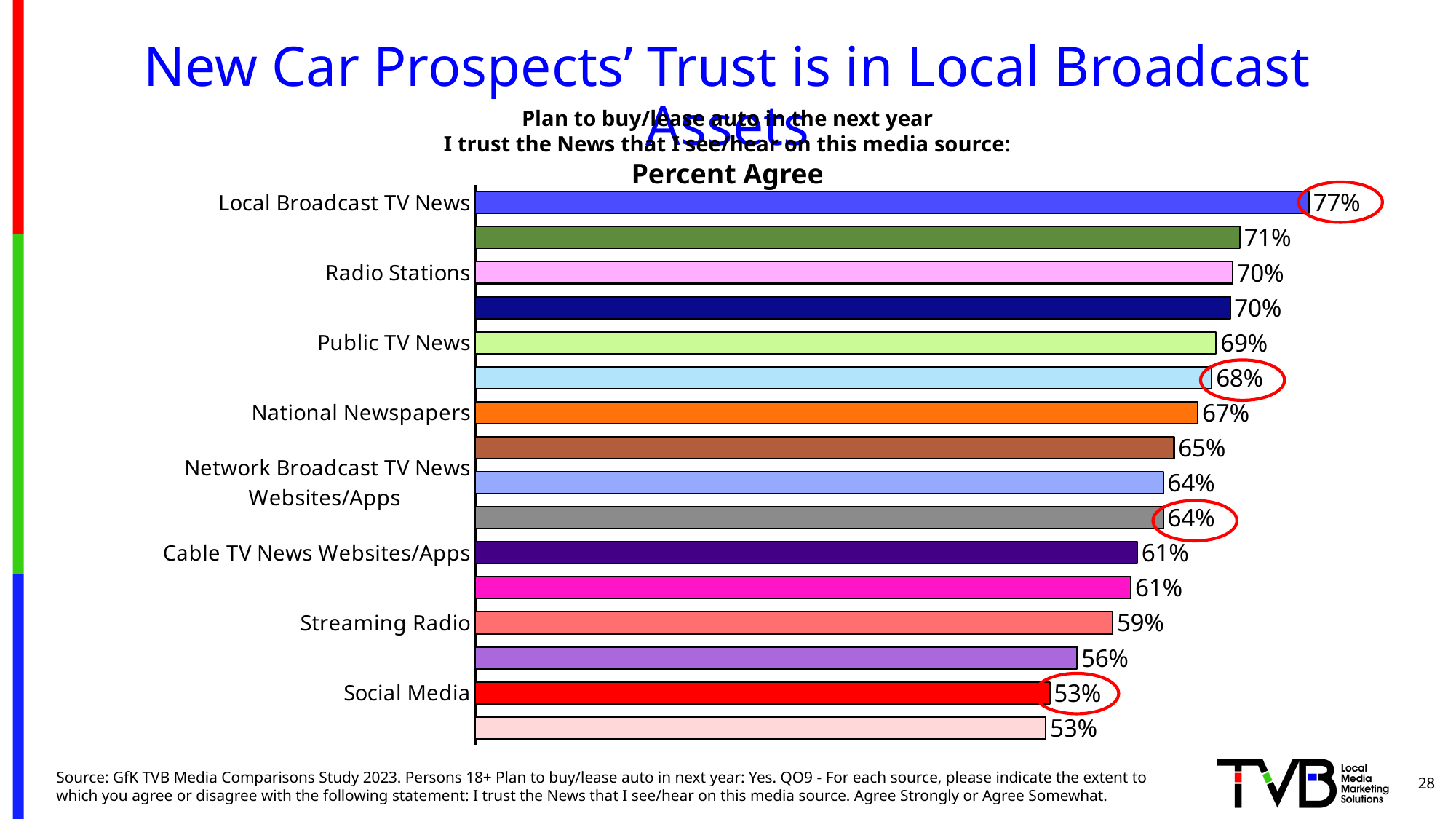
What is the Percent Agree value for Streaming Radio? 59% What kind of chart is shown on the slide? Bar chart Which has a higher Percent Agree value, Radio Stations or Cable TV News Websites/Apps? Radio Stations What is the Percent Agree value for Network Broadcast TV News Websites/Apps? 64% What is the Percent Agree value for Public TV News? 69% What is the Percent Agree value for Local Broadcast TV News? 77% What is the Percent Agree value for Radio Stations? 70% What is the Percent Agree value for National Newspapers? 67% What is the Percent Agree value for Social Media? 53% How many bars are plotted in the chart? 16 Which media source has the highest Percent Agree value? Local Broadcast TV News What is the difference in Percent Agree between Local Broadcast TV News and Social Media? 24 percentage points